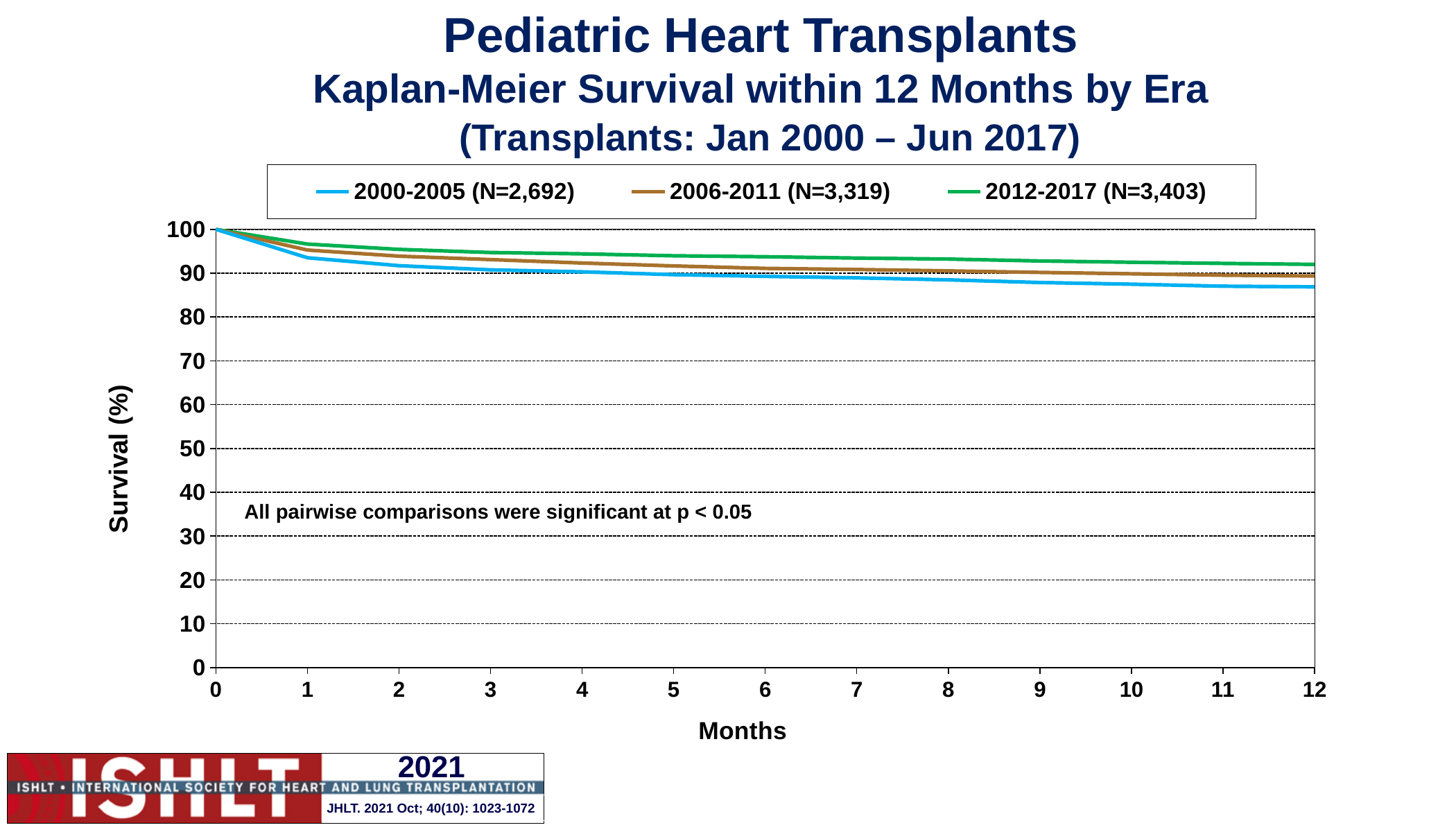
Which era has the highest survival at 12 months? 2012-2017 What is the label of the y axis? Survival (%) Do the survival curves rise or fall as months increase? Fall Is the survival value for the 2006-2011 era at 12 months greater or less than 80? greater At 12 months, is survival higher for the 2012-2017 era or the 2000-2005 era? 2012-2017 Is the survival value for the 2012-2017 era at 12 months greater or less than 90? greater What kind of chart is shown on the slide? Line chart What is the survival value for all eras at 0 months? 100 Which era has the lowest survival at 12 months? 2000-2005 Is the survival value for the 2000-2005 era at 12 months greater or less than 90? less What is the N for the 2006-2011 era shown in the legend? N=3,319 How many series does the legend list? 3